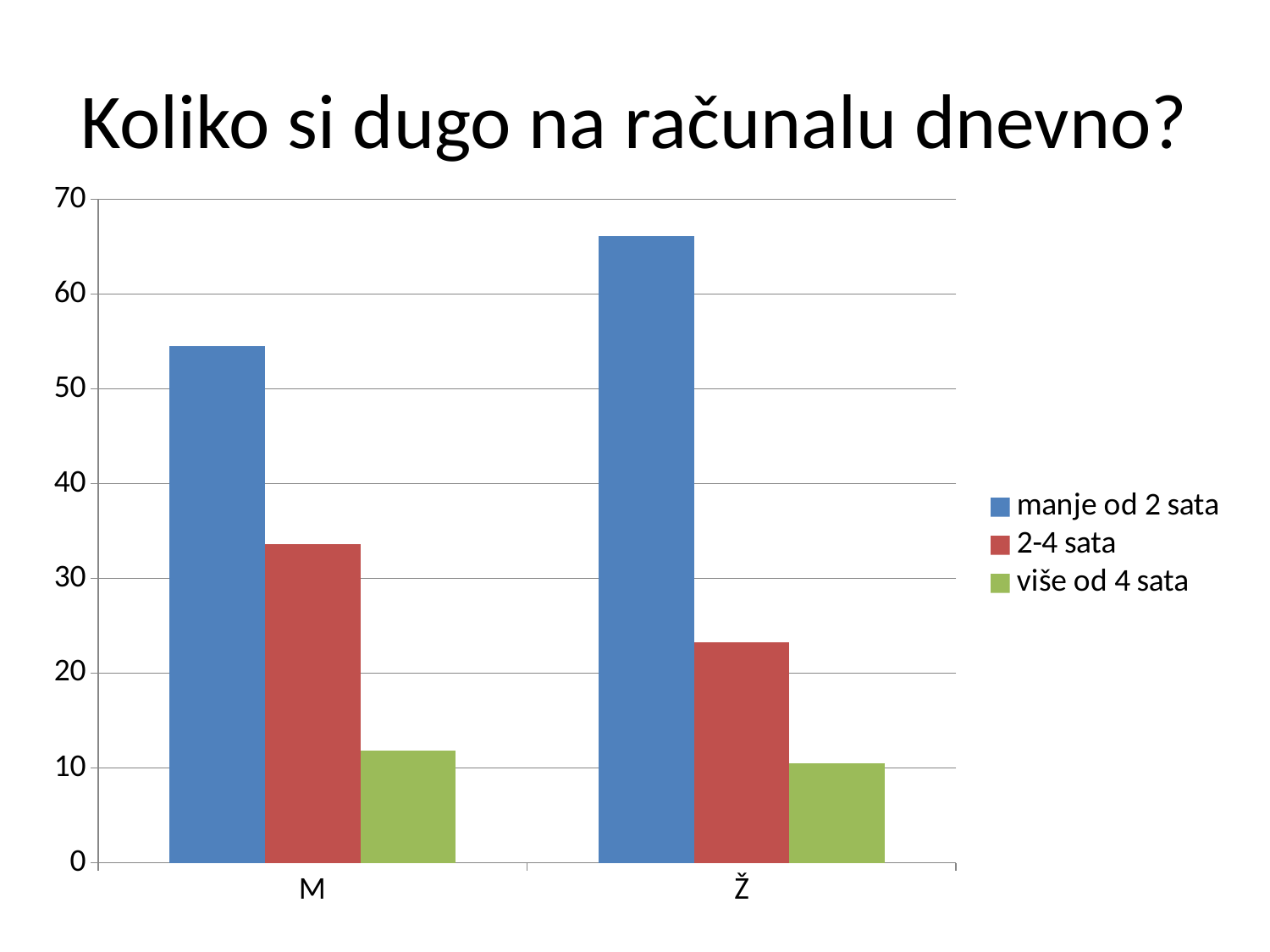
Is the value for 'manje od 2 sata' in category M greater or less than 60? less What is the title of the chart? Koliko si dugo na računalu dnevno? Is the value for '2-4 sata' in category Ž greater or less than 30? less Which category has the larger value for '2-4 sata', M or Ž? M What kind of chart is shown on the slide? bar chart Which series has the highest value for category Ž? manje od 2 sata How many series does the legend list? 3 Which category has the larger value for 'manje od 2 sata', M or Ž? Ž Is the value for '2-4 sata' in category M greater or less than 30? greater How many categories are shown on the x axis? 2 Which series has the lowest value for category M? više od 4 sata